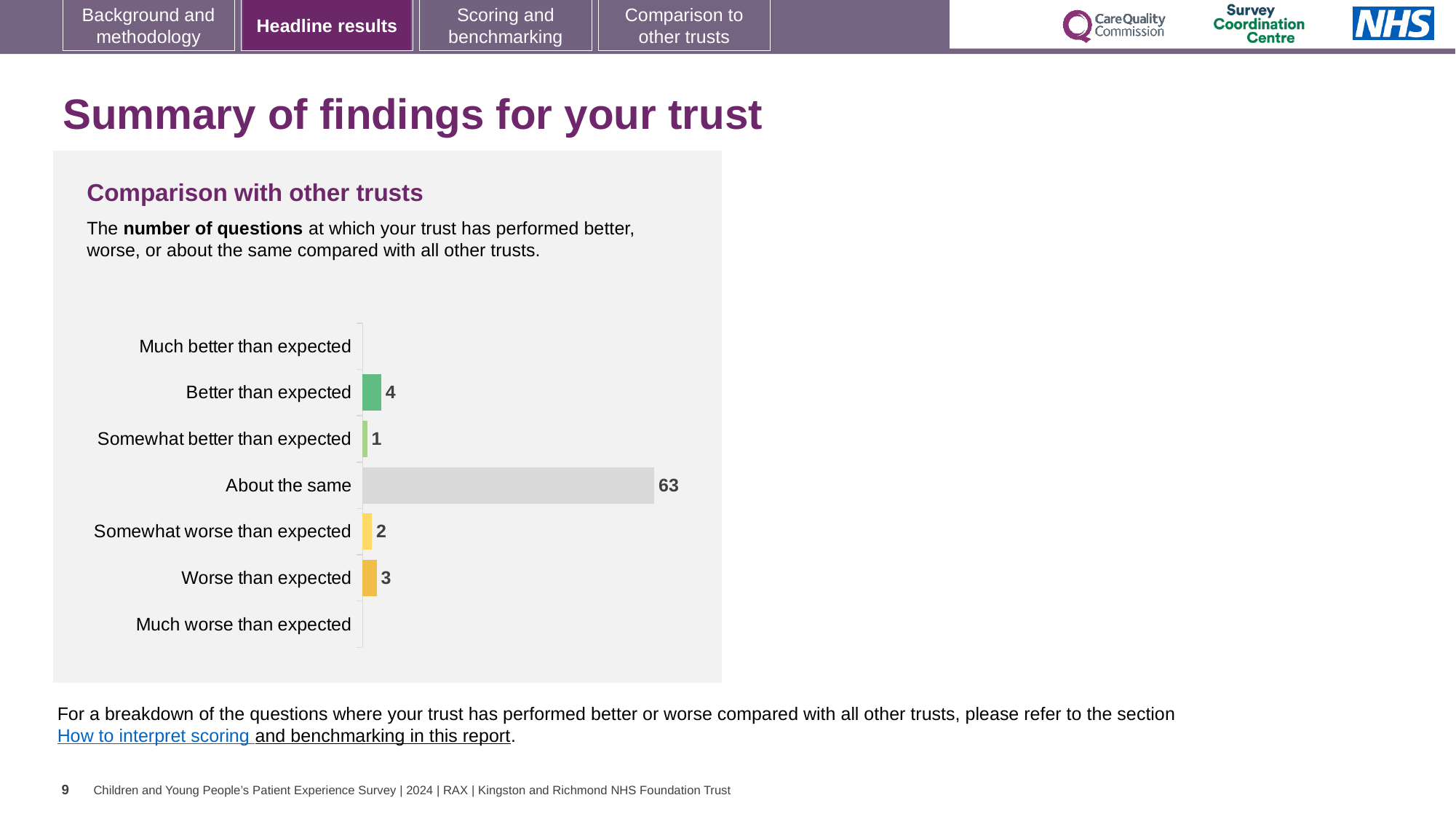
What is the difference between 'Better than expected' and 'Somewhat better than expected'? 3 What is the total number of questions across 'Better than expected' and 'Somewhat better than expected'? 5 Which is larger, 'Better than expected' or 'Worse than expected'? Better than expected What kind of chart is shown on the slide? Bar chart How many categories are shown on the chart? 7 What is the value for 'Worse than expected'? 3 Which category has the highest number of questions? About the same What is the value for 'Better than expected'? 4 What is the title of the chart? Comparison with other trusts What is the value for 'Somewhat worse than expected'? 2 What colour is the 'About the same' bar? Grey How many questions are in the 'About the same' category? 63